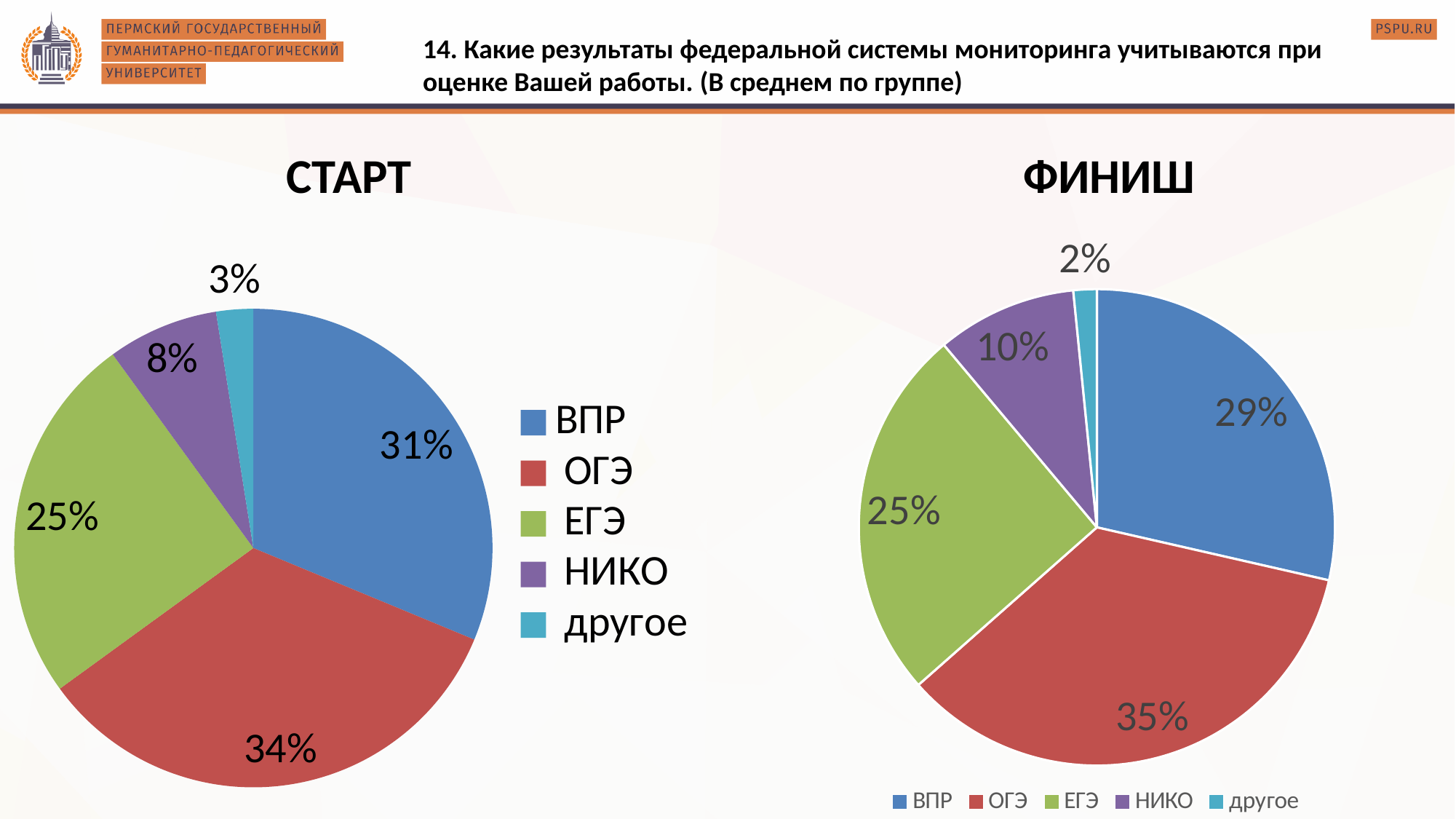
In the СТАРТ pie chart, what is the difference between the shares for ЕГЭ and НИКО? 17% In the ФИНИШ pie chart, what is the share for другое? 2% In the ФИНИШ pie chart, what is the difference between the shares for ОГЭ and ВПР? 6% In the ФИНИШ pie chart, which category has the smallest share? другое Which is larger: the share for ВПР in the СТАРТ chart or the share for ВПР in the ФИНИШ chart? СТАРТ In the СТАРТ pie chart, which category has the largest share? ОГЭ How many slices does the ФИНИШ pie chart have? 5 In the ФИНИШ pie chart, what is the share for НИКО? 10% What type of chart is used for СТАРТ and ФИНИШ? Pie chart In the СТАРТ pie chart, what is the share for ОГЭ? 34% In the СТАРТ pie chart, what is the share for ВПР? 31% Which colour represents ЕГЭ in the legend? Green